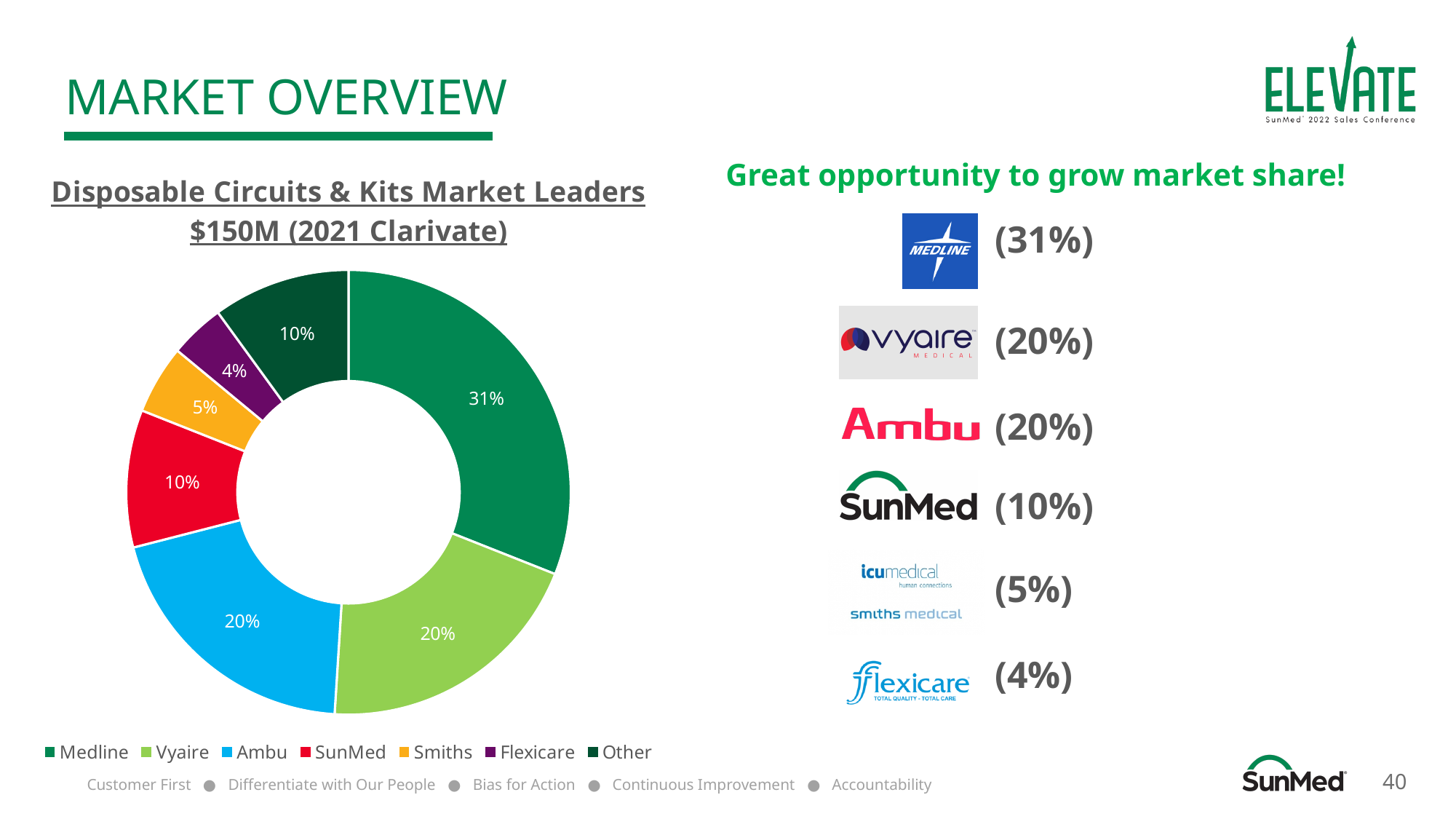
Which company has the smallest share in the donut chart? Flexicare What share of the Disposable Circuits & Kits market does Medline hold? 31% What colour represents Ambu in the donut chart? Light blue What is the difference between Medline's share and Ambu's share? 11% Which company has the largest share in the donut chart? Medline Which has a larger share, SunMed or Smiths? SunMed How many categories does the legend of the donut chart list? 7 What share of the market does Smiths hold? 5% What is the title of the chart? Disposable Circuits & Kits Market Leaders $150M (2021 Clarivate) What share of the market does Flexicare hold? 4% What kind of chart is shown on the slide? Donut (pie) chart What share of the market does SunMed hold in the donut chart? 10%